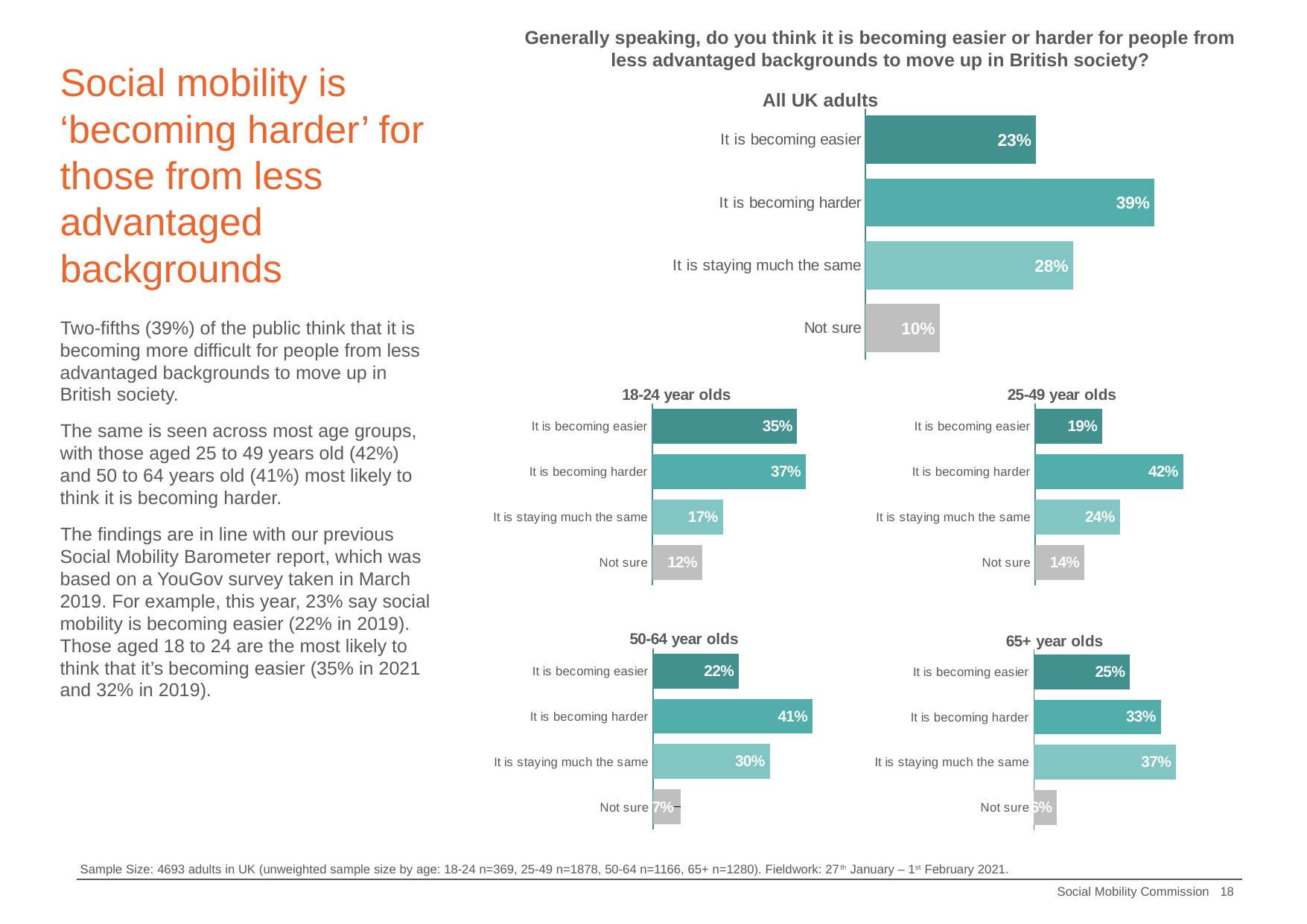
In the 'All UK adults' chart, what percentage say it is becoming harder? 39% In the '25-49 year olds' chart, which is larger: 'It is becoming easier' or 'It is staying much the same'? It is staying much the same In the 'All UK adults' chart, what percentage say it is becoming easier? 23% In the 'All UK adults' chart, what is the difference between 'It is becoming harder' and 'It is staying much the same'? 11% In the '65+ year olds' chart, which response has the highest value? It is staying much the same In the '50-64 year olds' chart, what percentage say it is staying much the same? 30% How many response categories are shown in the '65+ year olds' chart? 4 In the '18-24 year olds' chart, which response has the highest value? It is becoming harder In the '18-24 year olds' chart, what percentage say it is becoming easier? 35% What type of chart is used for the 'All UK adults' data? Bar chart In the 'All UK adults' chart, which response has the lowest value? Not sure In the '25-49 year olds' chart, what percentage say it is becoming harder? 42%